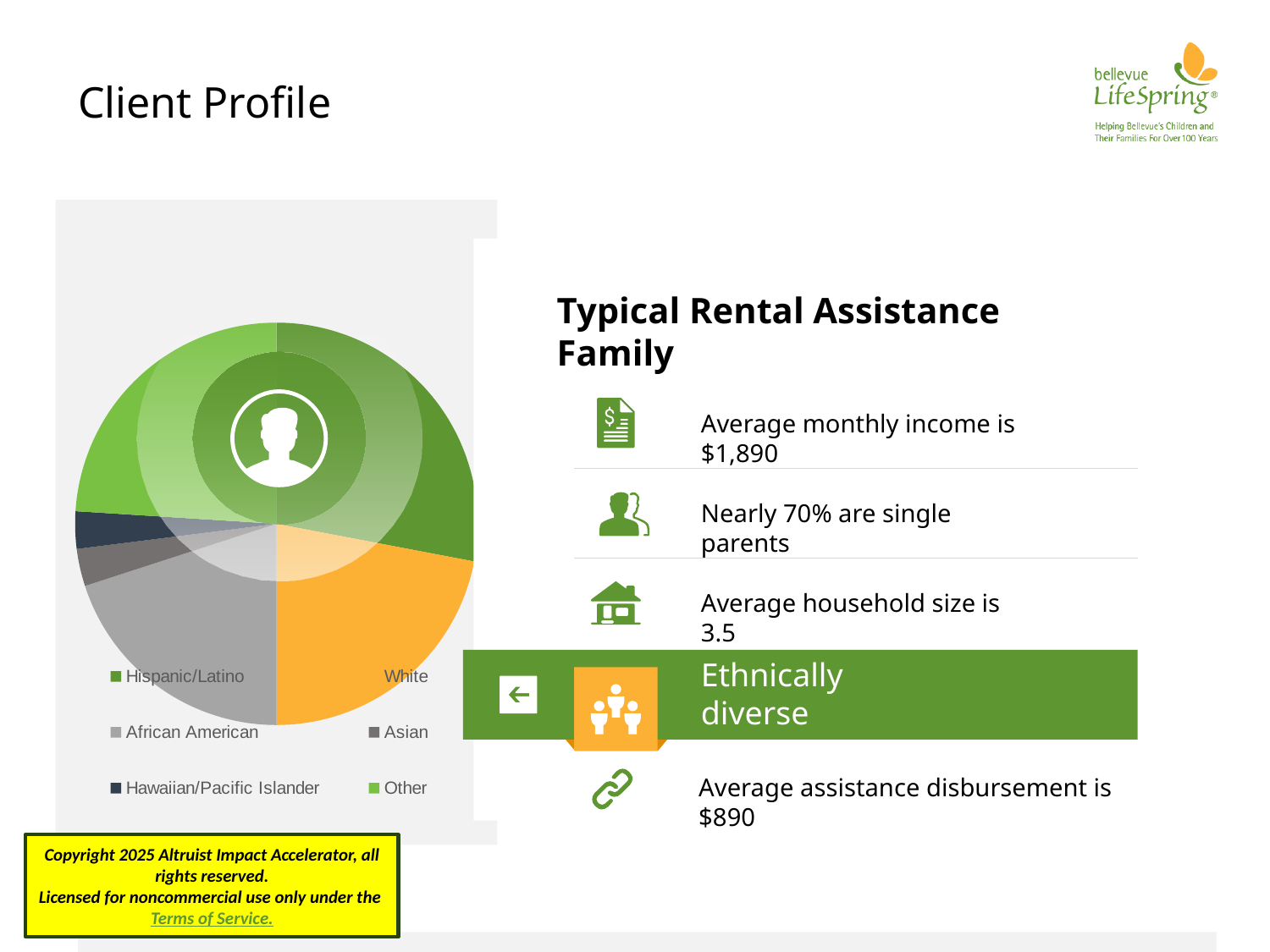
What colour represents Hispanic/Latino in the pie chart's legend? Green How many categories does the pie chart's legend list? 6 In the pie chart, which slice is larger: African American or Asian? African American In the pie chart, which slice is larger: White or Asian? White Which legend entry in the pie chart is shown in dark navy blue? Hawaiian/Pacific Islander In the pie chart, which slice is larger: White or Hawaiian/Pacific Islander? White What kind of chart is shown on the left of the slide? Pie chart